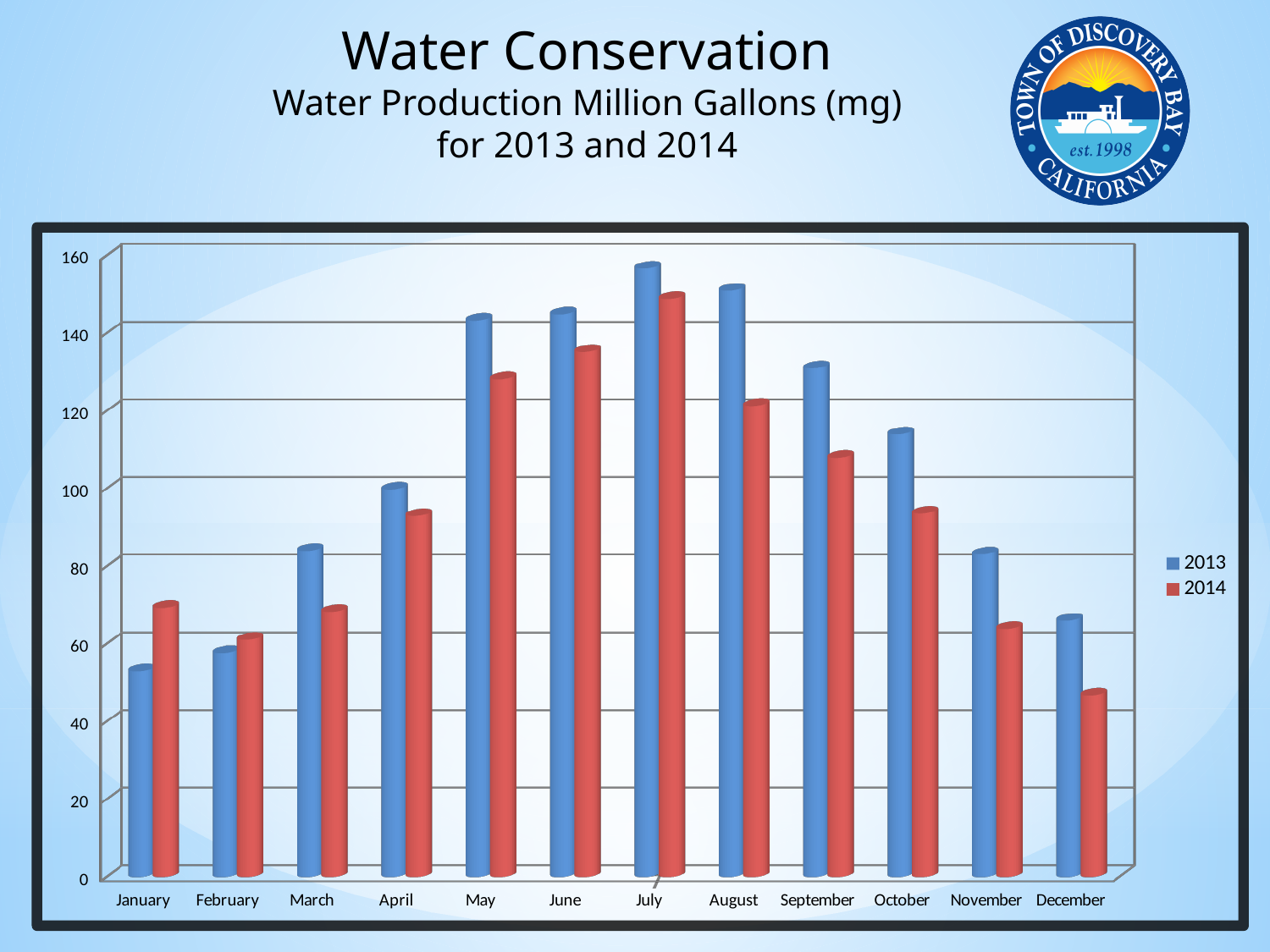
Which month has the highest water production for 2014? July How many series does the legend list? 2 Which month has the highest water production for 2013? July Is the value for December 2014 greater or less than 60? less In August, which year has the larger water production, 2013 or 2014? 2013 Is the value for July 2013 greater or less than 140? greater What kind of chart is shown on the slide? bar chart Which month has the lowest water production for 2013? January Do the 2013 values rise or fall from January to July? rise In January, which year has the larger water production, 2013 or 2014? 2014 How many months are shown along the x axis? 12 Which month has the lowest water production for 2014? December